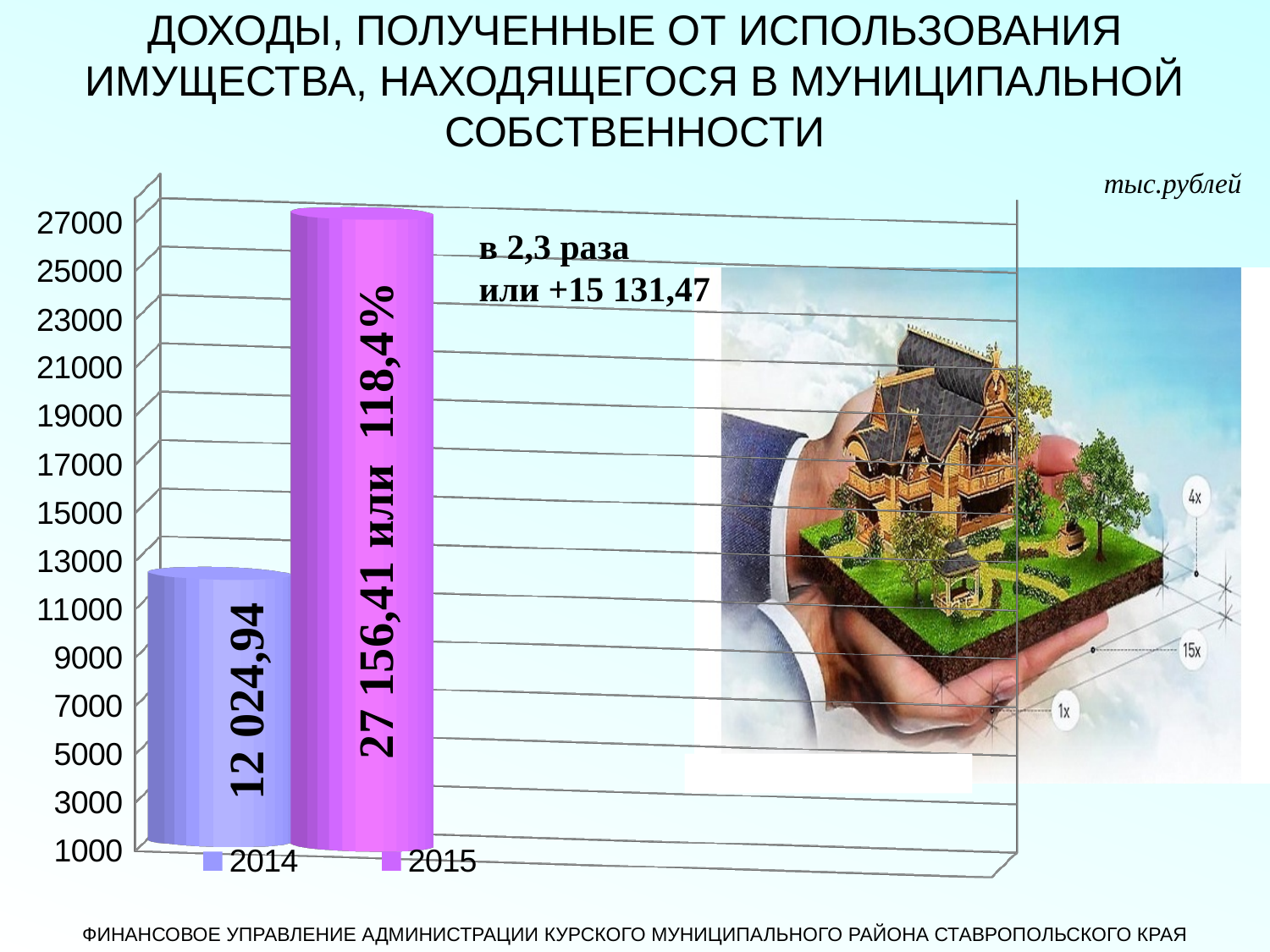
What kind of chart is shown on the slide? bar chart Is the value for 2014 greater or less than 13000? less What is the difference between the 2015 and 2014 values? 15 131,47 What is the value for 2015? 27 156,41 Is the value for 2015 greater or less than 25000? greater Which year has the highest value? 2015 How many series does the legend list? 2 What is the value for 2014? 12 024,94 Which year has the lowest value? 2014 Which year has the higher value, 2014 or 2015? 2015 Do the values rise or fall from 2014 to 2015? rise What unit of measurement is indicated for the chart? тыс.рублей